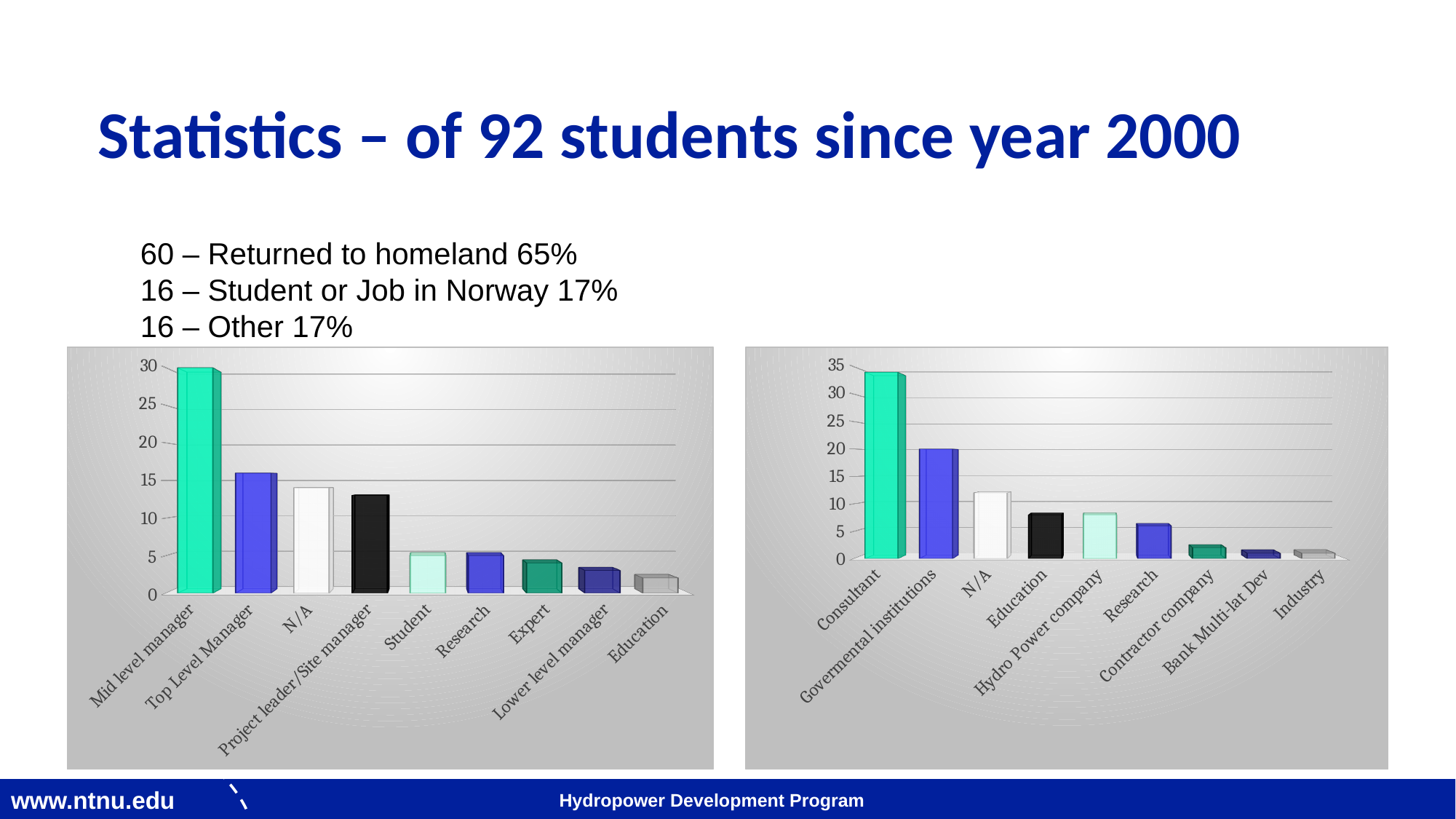
In the chart on the right side of the slide, which category has the highest value? Consultant In the chart on the left side of the slide, which category has the highest value? Mid level manager In the chart on the right side of the slide, is the value for Governmental institutions greater or less than 25? less In the chart on the left side of the slide, is the value for Mid level manager greater or less than 25? greater How many categories are shown in the chart on the left side of the slide? 9 In the chart on the left side of the slide, which is larger, the value for N/A or the value for Expert? N/A What kind of chart is the chart on the left side of the slide? bar chart In the chart on the right side of the slide, is the value for Consultant greater or less than 30? greater How many categories are shown in the chart on the right side of the slide? 9 In the chart on the right side of the slide, do the values rise or fall from left to right along the x axis? fall In the chart on the left side of the slide, which category has the lowest value? Education